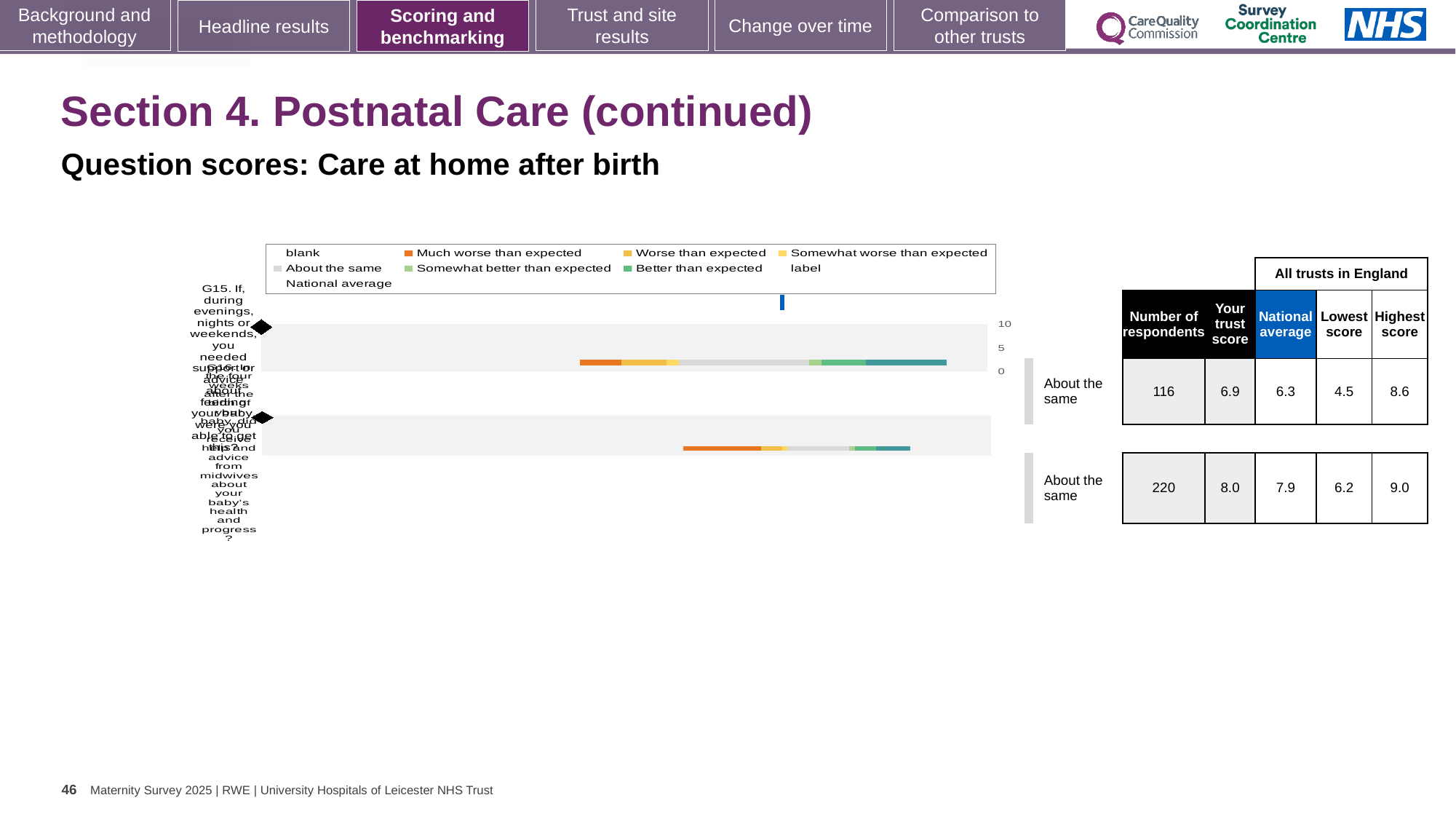
Which question row has the larger number of respondents, the first or the second? the second (220) What kind of chart is shown on the slide? bar chart In the table, what is the highest score among all trusts in England for the second question row? 9.0 In the table, what is 'Your trust score' for the first question row (G15)? 6.9 In the table, what is the lowest score among all trusts in England for the first question row (G15)? 4.5 How many entries does the chart legend list? 9 In the table, what is the number of respondents for the first question row (G15)? 116 In the table, what is the national average for the second question row? 7.9 How many question rows (bars) are plotted in the chart? 2 What is the difference between the trust score and the national average for the first question row (G15)? 0.6 Which colour does the legend use for 'Much worse than expected'? orange Which legend entry is shown in light grey? About the same